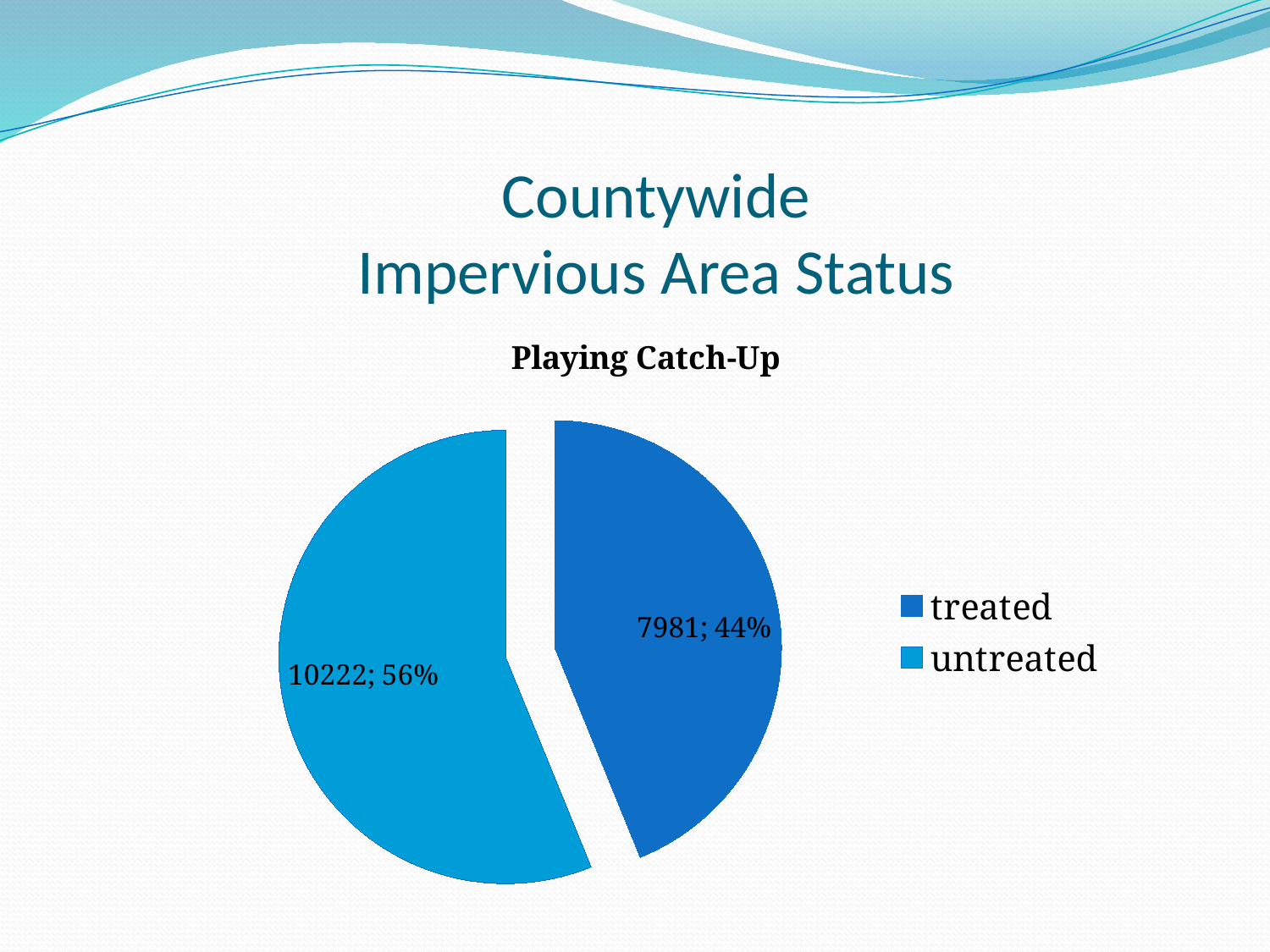
Which is larger, treated or untreated? untreated What is the value for the untreated slice? 10222 How many slices does the pie chart have? 2 What kind of chart is shown on the slide? pie chart What is the title of the chart? Playing Catch-Up Which slice is the smallest? treated What is the value for the treated slice? 7981 What share of the pie does the treated slice represent? 44% What is the difference between the untreated and treated values? 2241 How many entries does the legend list? 2 Which slice is the largest? untreated What share of the pie does the untreated slice represent? 56%